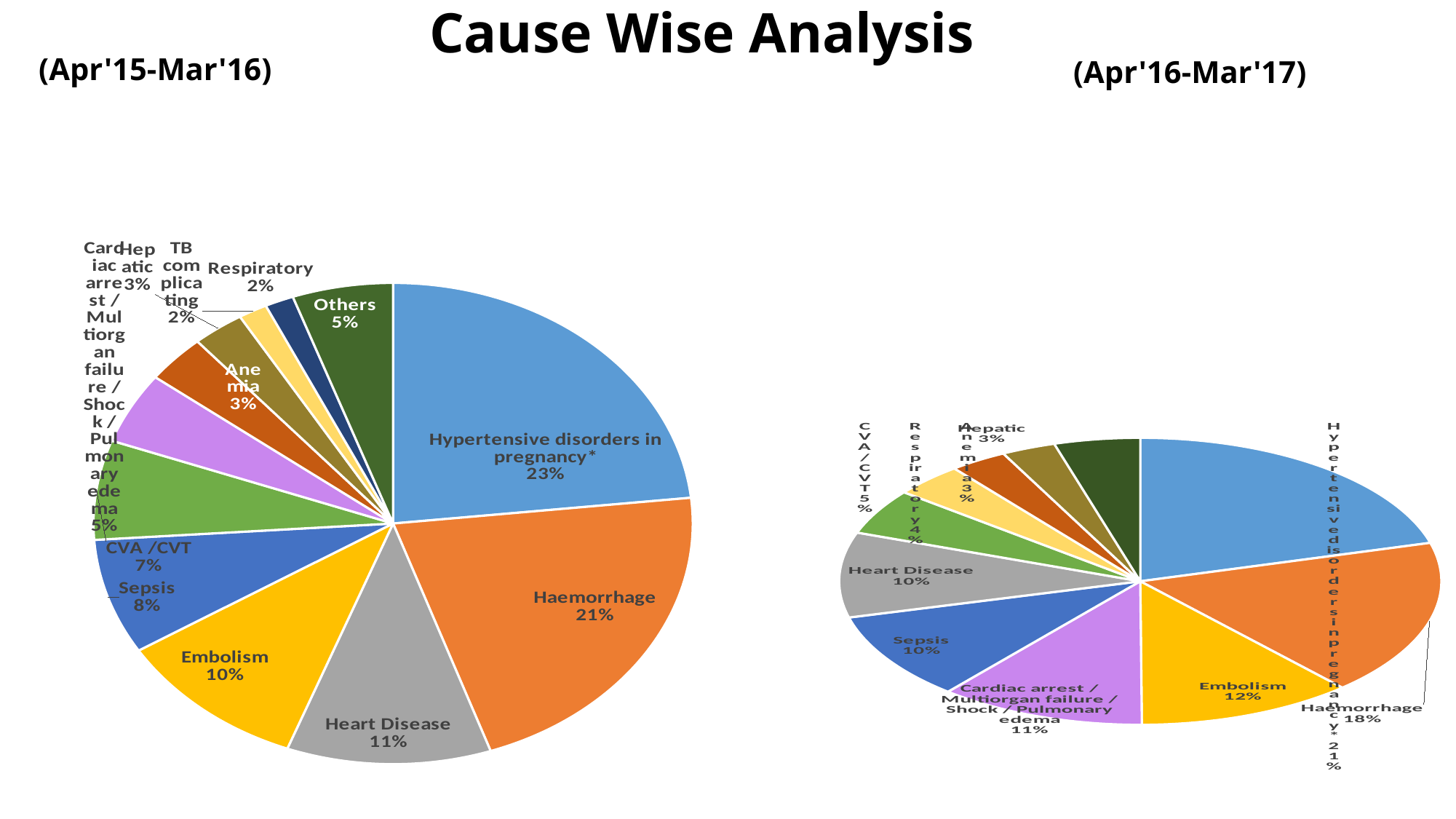
In the Apr'16-Mar'17 pie chart, which is larger, the share for Embolism or the share for Sepsis? Embolism In the Apr'16-Mar'17 pie chart, what percentage is shown for Embolism? 12% In the Apr'15-Mar'16 pie chart, what share is labelled for Others? 5% In the Apr'16-Mar'17 pie chart, what share is shown for Cardiac arrest / Multiorgan failure / Shock / Pulmonary edema? 11% In the Apr'15-Mar'16 pie chart, which is larger, the share for Sepsis or the share for CVA /CVT? Sepsis In the Apr'16-Mar'17 pie chart, what share does Haemorrhage account for? 18% In the Apr'15-Mar'16 pie chart, what is the difference between the shares of Heart Disease and Sepsis? 3% In the Apr'15-Mar'16 pie chart, what percentage is shown for Embolism? 10% In the Apr'15-Mar'16 pie chart, which cause has the largest share? Hypertensive disorders in pregnancy What type of chart is used on this slide for both periods? Pie chart In the Apr'15-Mar'16 pie chart, what share does Haemorrhage account for? 21% What is the title of the slide? Cause Wise Analysis